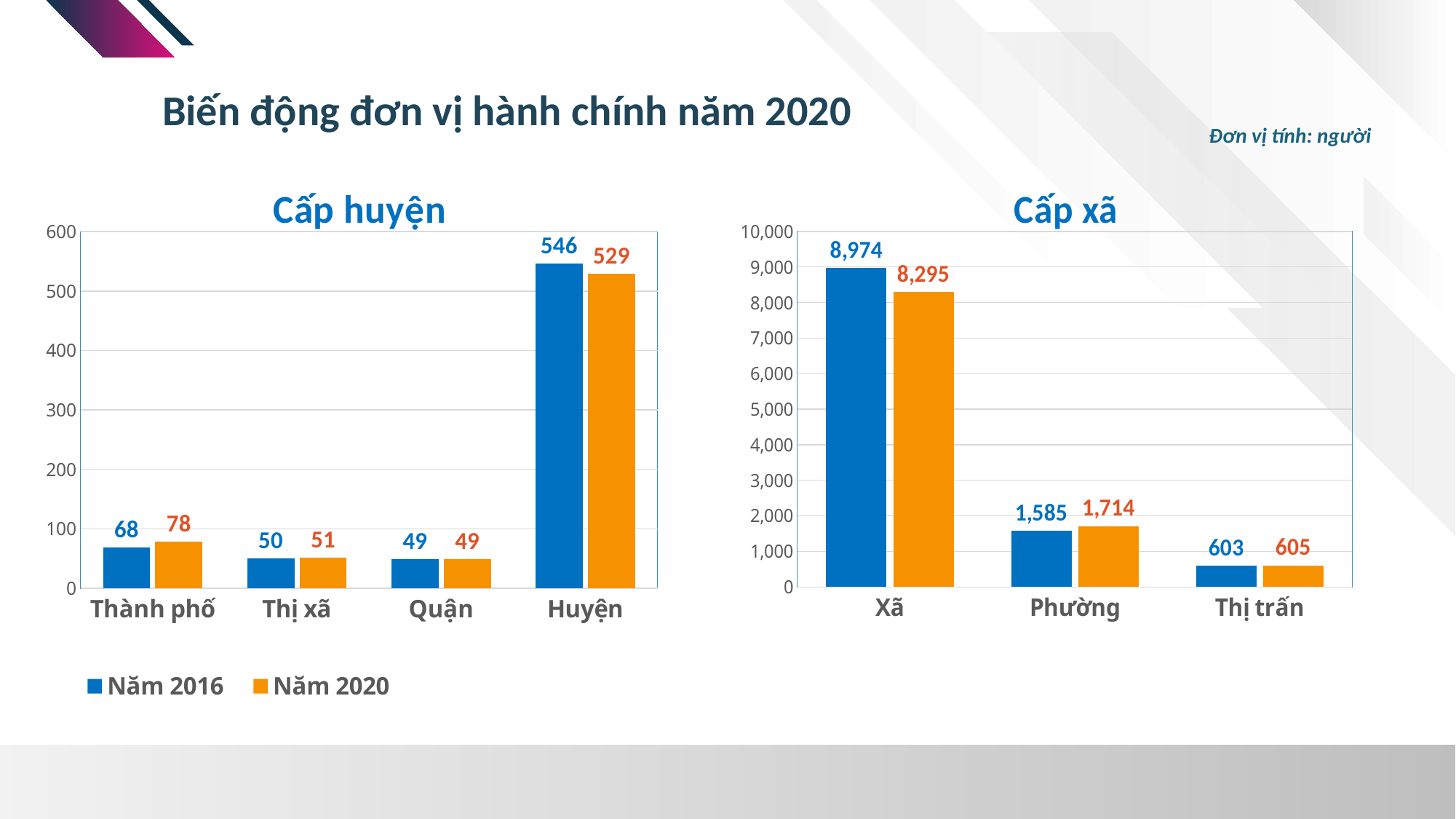
How many series does the legend list? 2 In the 'Cấp huyện' chart, what is the value for Huyện in Năm 2016? 546 In the 'Cấp huyện' chart, which category has the highest value in Năm 2020? Huyện In the 'Cấp huyện' chart, what is the value for Thành phố in Năm 2020? 78 In the 'Cấp xã' chart, what is the value for Phường in Năm 2016? 1,585 How many categories are shown on the x axis of the 'Cấp huyện' chart? 4 In the 'Cấp xã' chart, which is larger for Phường: the Năm 2016 value or the Năm 2020 value? Năm 2020 What kind of chart is the 'Cấp xã' chart? Bar chart In the 'Cấp xã' chart, which category has the lowest value in Năm 2016? Thị trấn In the 'Cấp xã' chart, what is the value for Xã in Năm 2020? 8,295 In the 'Cấp xã' chart, what is the difference between the Năm 2016 and Năm 2020 values for Xã? 679 In the 'Cấp huyện' chart, what is the difference between the Năm 2016 and Năm 2020 values for Huyện? 17